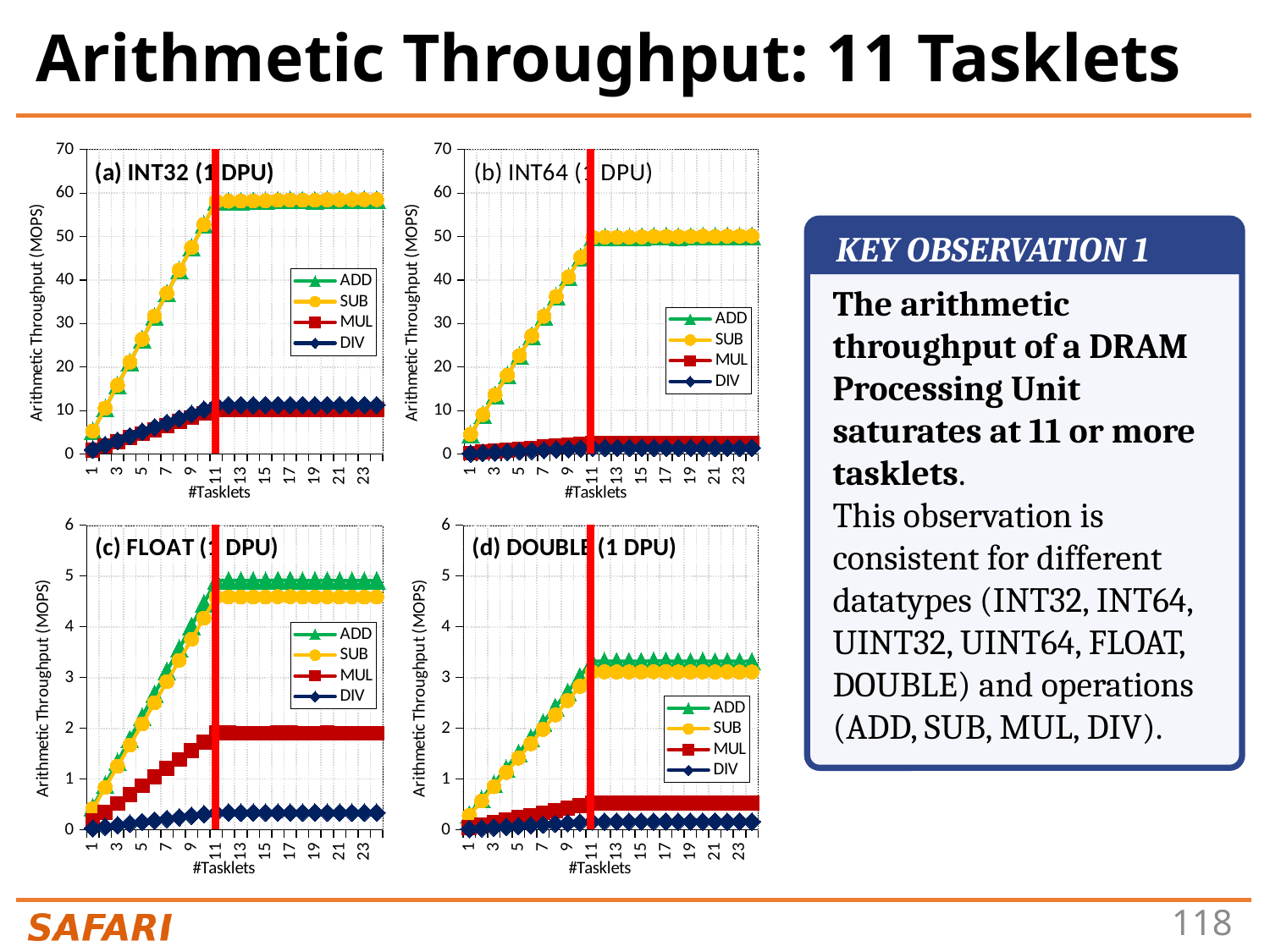
In chart (a) INT32 (1 DPU), is the value for ADD at 23 tasklets greater or less than 50? greater How many series does the legend of chart (b) INT64 (1 DPU) list? 4 In chart (c) FLOAT (1 DPU), which is larger at 23 tasklets, MUL or DIV? MUL In chart (b) INT64 (1 DPU), is the value for MUL at 23 tasklets greater or less than 10? less What is the y-axis label of chart (c) FLOAT (1 DPU)? Arithmetic Throughput (MOPS) In chart (c) FLOAT (1 DPU), is the value for ADD at 23 tasklets greater or less than 4? greater In chart (d) DOUBLE (1 DPU), how does the ADD throughput change as the number of tasklets increases from 1 to 11? It rises What kind of chart is chart (a) INT32 (1 DPU)? line chart In chart (c) FLOAT (1 DPU), which series has the lowest throughput at 23 tasklets? DIV